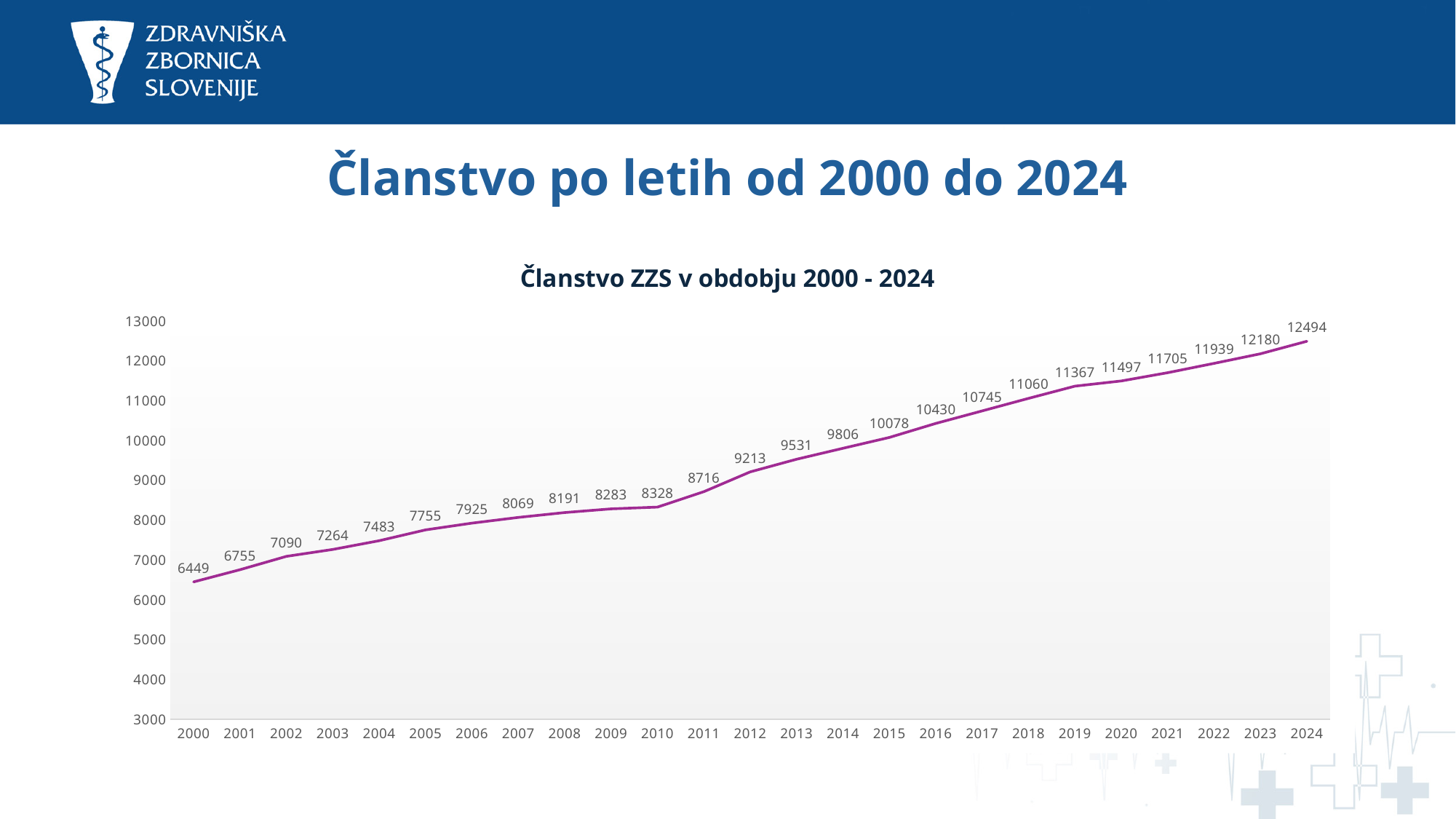
Is the membership value for 2018 greater or less than 11000? greater What kind of chart is shown on the slide? line chart What is the membership value shown for 2012? 9213 What is the membership value shown for 2024? 12494 Which year has a larger membership value, 2010 or 2015? 2015 Which year has the lowest membership value? 2000 What is the membership value shown for 2000? 6449 What is the difference between the membership values for 2024 and 2000? 6045 How many years are plotted on the chart? 25 What is the difference between the membership values for 2012 and 2011? 497 Do the membership values rise or fall from 2000 to 2024? rise Which year has the highest membership value? 2024